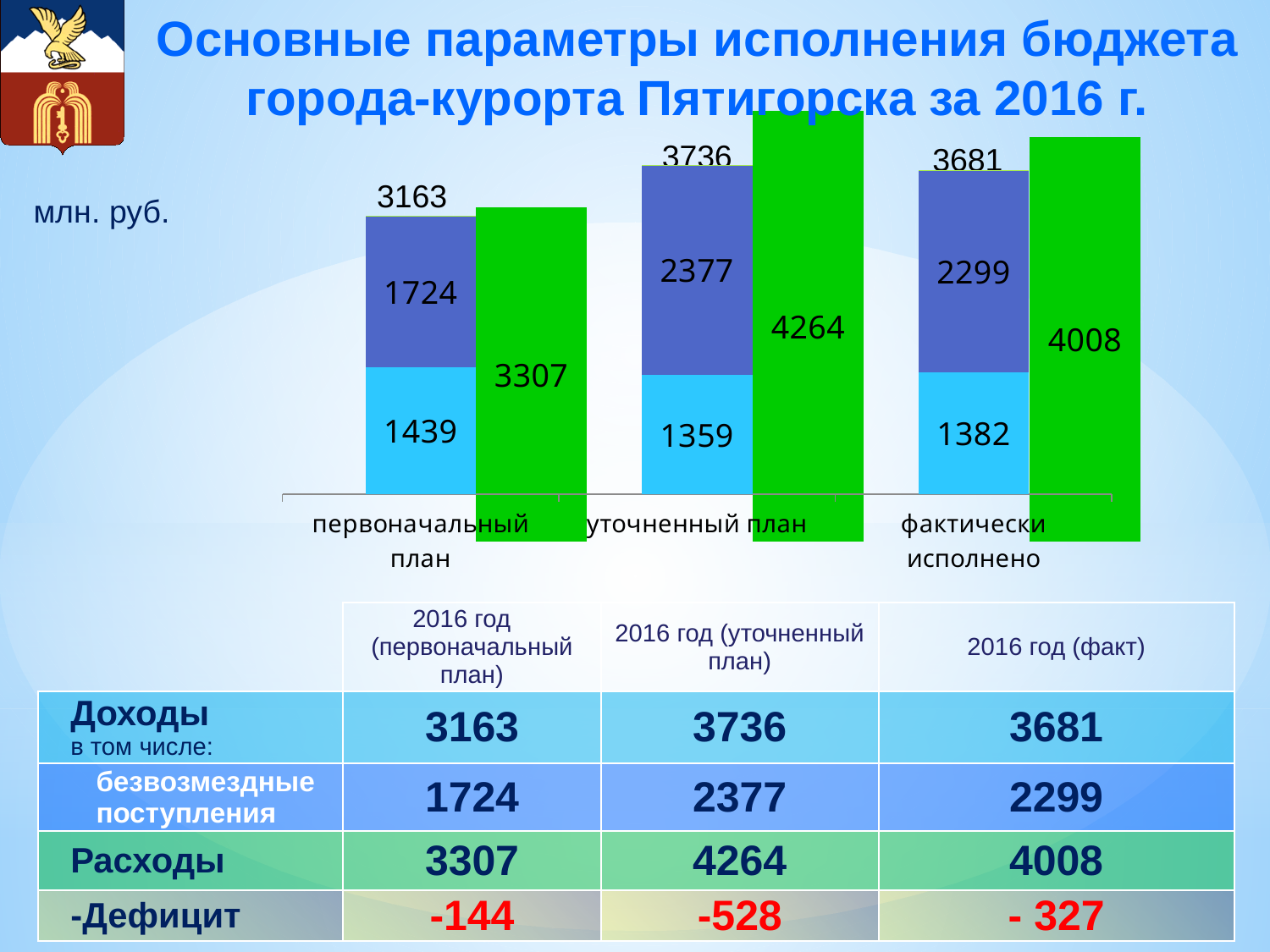
Which is larger for "первоначальный план": the green bar or the stacked blue bar total? the green bar Which category has the highest green bar? уточненный план Which category has the lowest stacked blue bar total? первоначальный план What is the value of the green bar for "уточненный план"? 4264 What is the value of the green bar for "фактически исполнено"? 4008 What is the difference between the green bar and the stacked blue bar total for "уточненный план"? 528 What is the total of the stacked (blue) bar for "первоначальный план"? 3163 What unit is indicated for the chart values on the slide? млн. руб. How many categories are shown on the x axis of the chart? 3 What type of chart is shown on the slide? bar chart What is the value of the dark blue segment for "фактически исполнено"? 2299 What is the value of the light blue segment for "уточненный план"? 1359